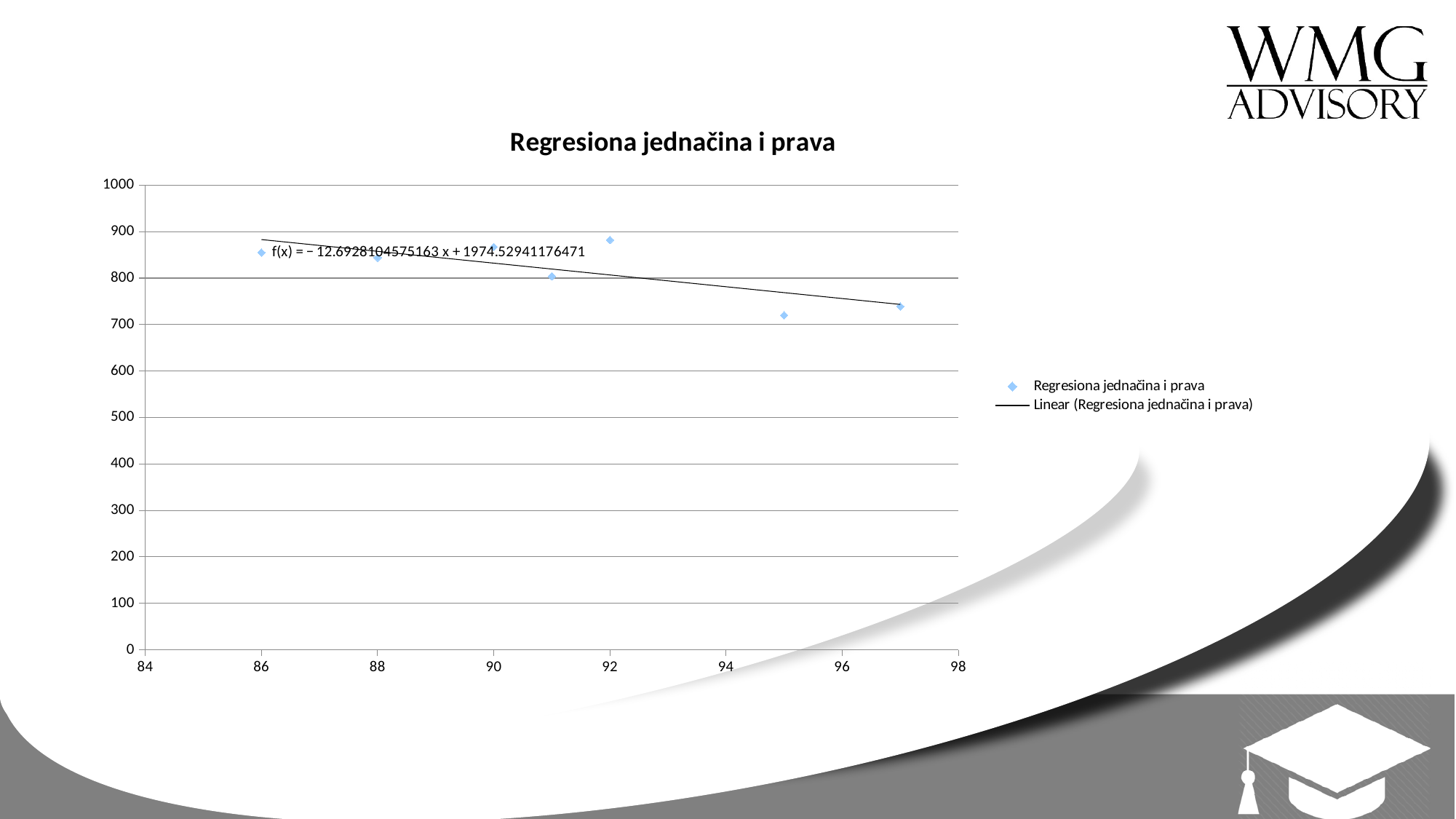
Is the value of the point at x = 95 greater or less than 800? less At which x value is the lowest plotted point? 95 What kind of chart is shown on the slide? scatter chart What is the title of the chart? Regresiona jednačina i prava How many entries does the chart legend list? 2 Is the value of the point at x = 97 greater or less than 700? greater Which has the larger value, the point at x = 86 or the point at x = 95? x = 86 Do the plotted values generally rise or fall as x increases from 86 to 97? fall How many data points are plotted in the chart? 7 Is the value of the point at x = 91 greater or less than 900? less What is the slope of the linear trendline equation shown on the chart? −12.6928104575163